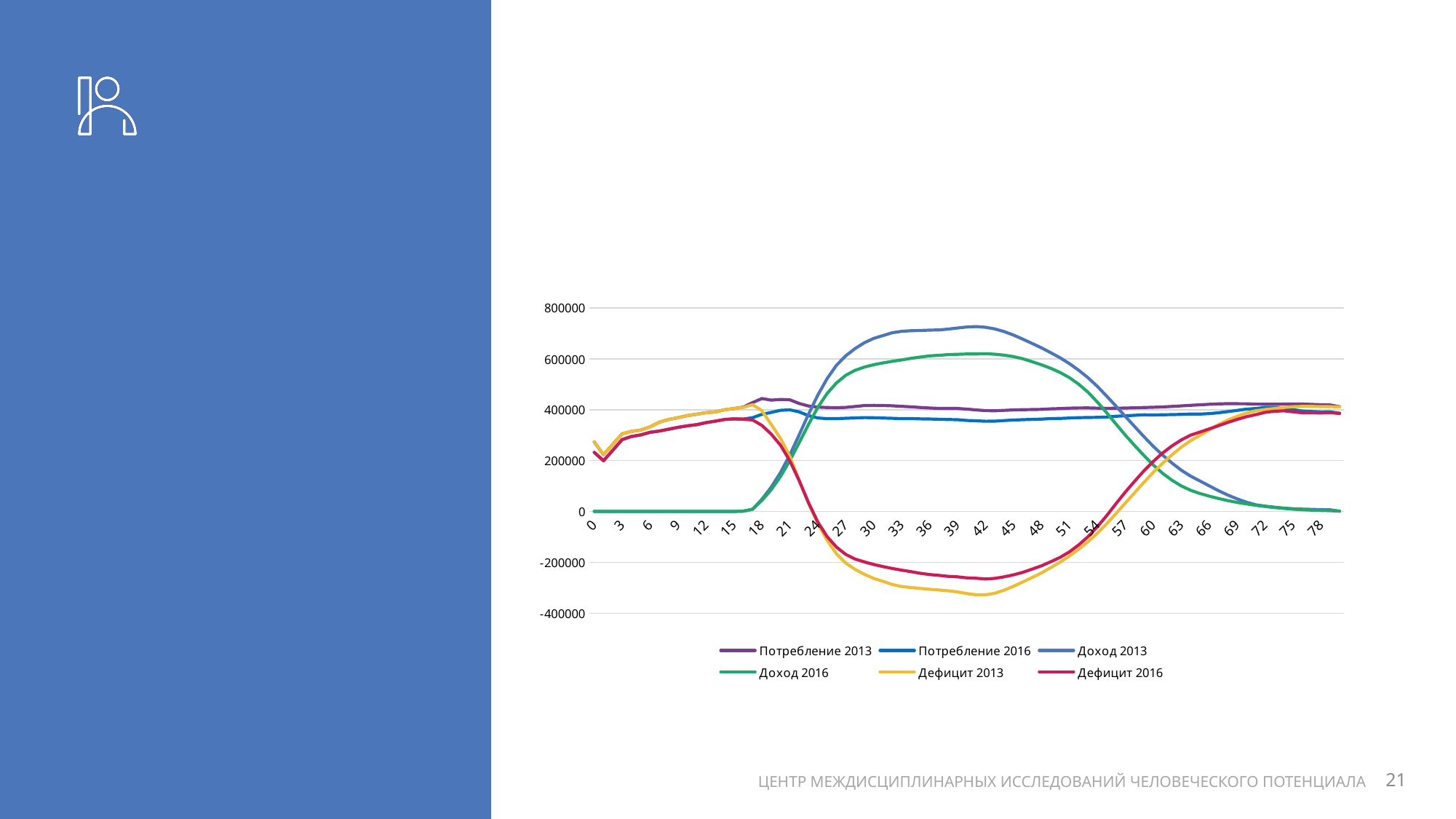
Is the value of Дефицит 2016 at x = 42 greater or less than -200000? less At x = 42, which is larger: Дефицит 2013 or Дефицит 2016? Дефицит 2016 How many labelled tick marks are there on the x axis? 27 What kind of chart is shown on the slide? line chart Which series reaches the highest value on the chart? Доход 2013 Which series reaches the lowest value on the chart? Дефицит 2013 Does the Доход 2013 line rise or fall between x = 18 and x = 42? rise Is the value of Дефицит 2013 at x = 42 greater or less than -200000? less At x = 42, which is larger: Доход 2013 or Доход 2016? Доход 2013 Is the value of Доход 2016 at x = 42 greater or less than 400000? greater How many series does the legend list? 6